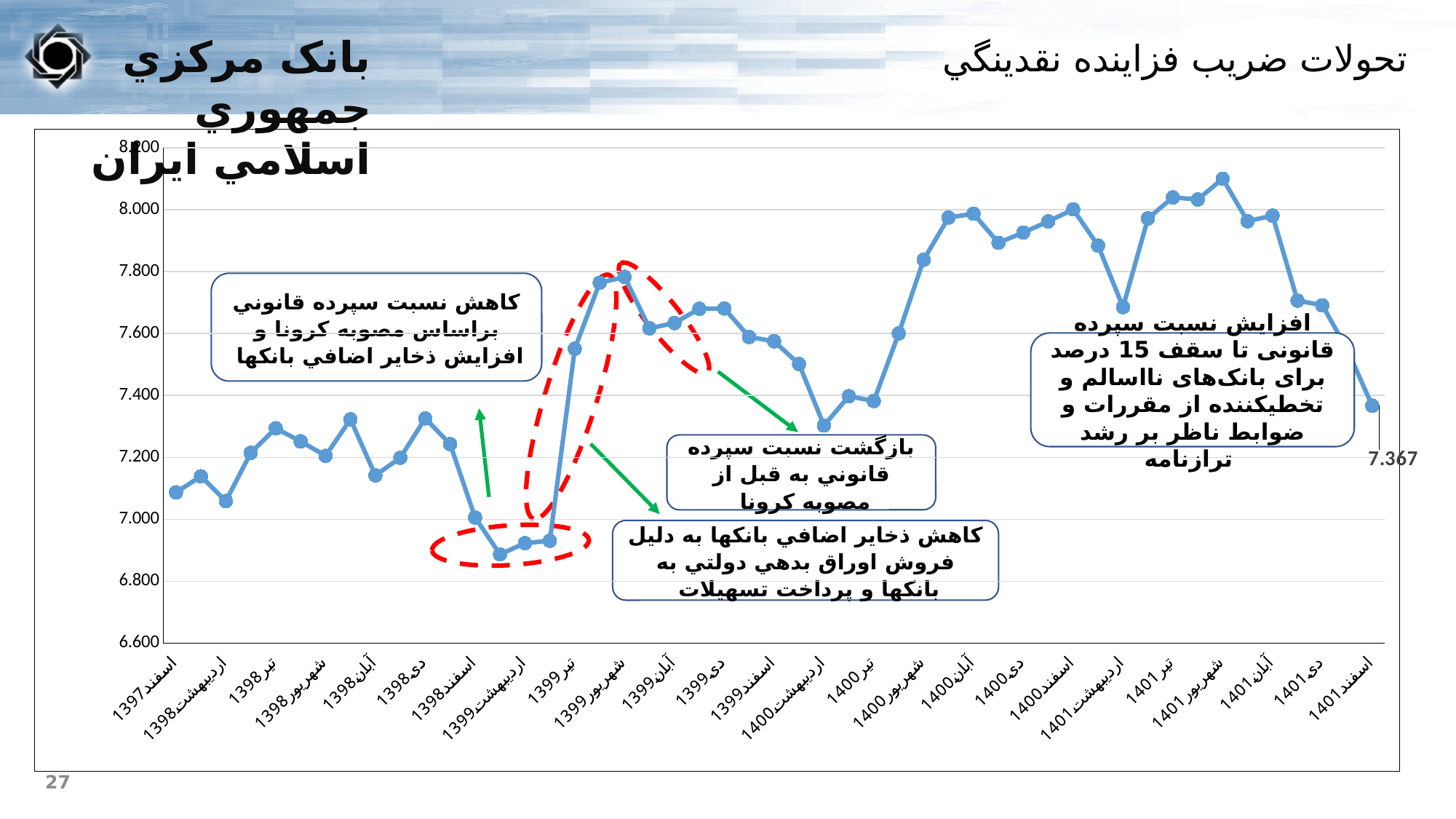
What is the title of the slide containing the chart? تحولات ضریب فزاینده نقدینگی Is the value for دی 1399 greater or less than 7.600? greater Is the value for اردیبهشت 1400 greater or less than 7.400? less Is the value for اسفند 1397 greater or less than 7.200? less What kind of chart is shown on the slide? line chart Which is larger, the value at اسفند 1397 or the value at اسفند 1401? اسفند 1401 Does the line rise or fall between اردیبهشت 1399 and تیر 1399? rise What is the value of the money multiplier (ضریب فزاینده نقدینگی) at اسفند 1401, the last point on the chart? 7.367 At which x-axis label does the line reach its highest point? شهریور 1401